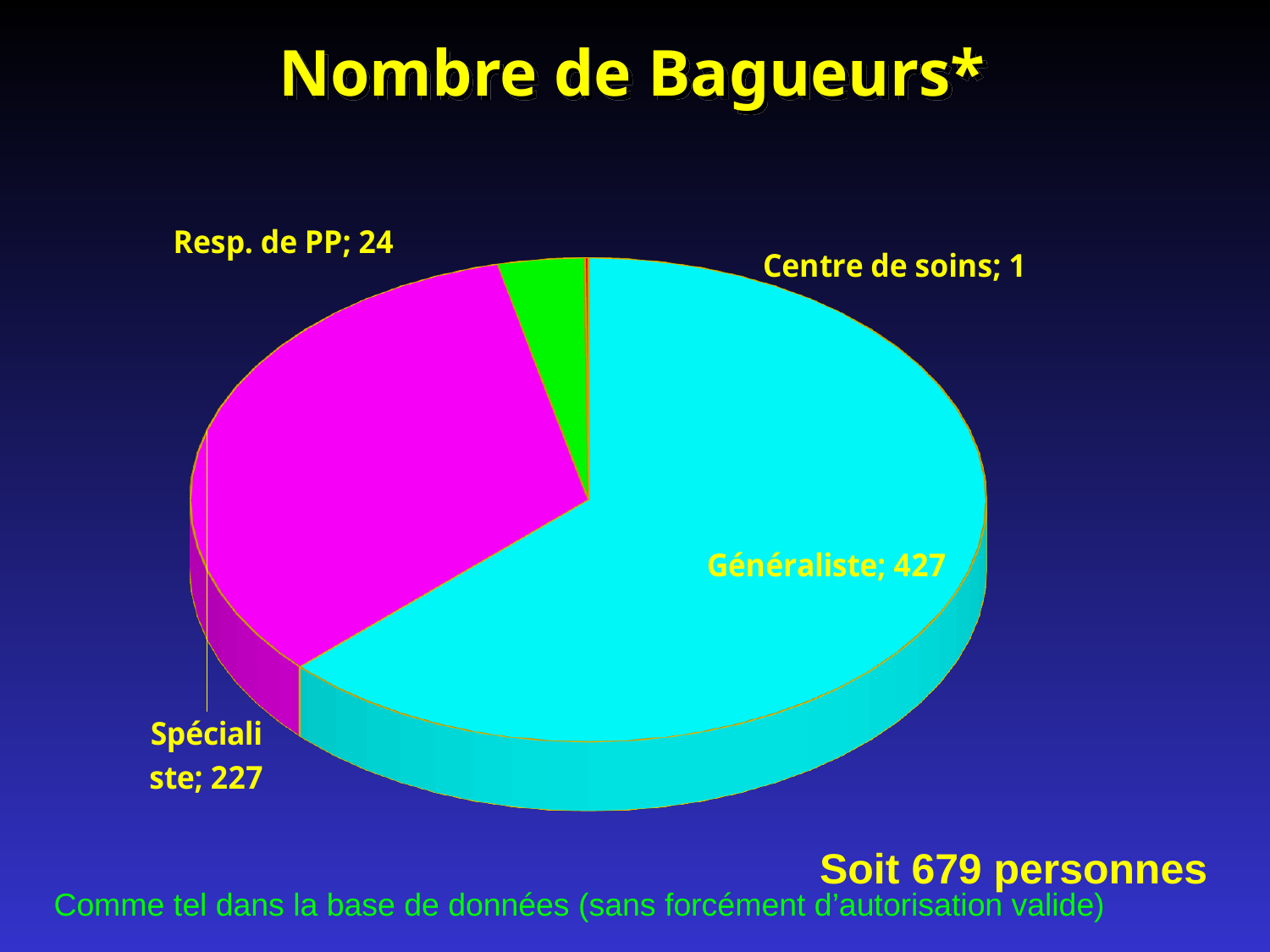
Which category has the largest slice of the pie? Généraliste What is the total of all the slices in the pie chart? 679 What is the value for Spécialiste? 227 What kind of chart is shown on the slide? Pie chart Which is larger, the value for Spécialiste or the value for Resp. de PP? Spécialiste What is the value for Centre de soins? 1 What is the difference between the values for Généraliste and Spécialiste? 200 Which category has the smallest slice of the pie? Centre de soins What is the title of the chart? Nombre de Bagueurs* What is the value for Resp. de PP? 24 What is the value for Généraliste? 427 How many categories are shown in the pie chart? 4